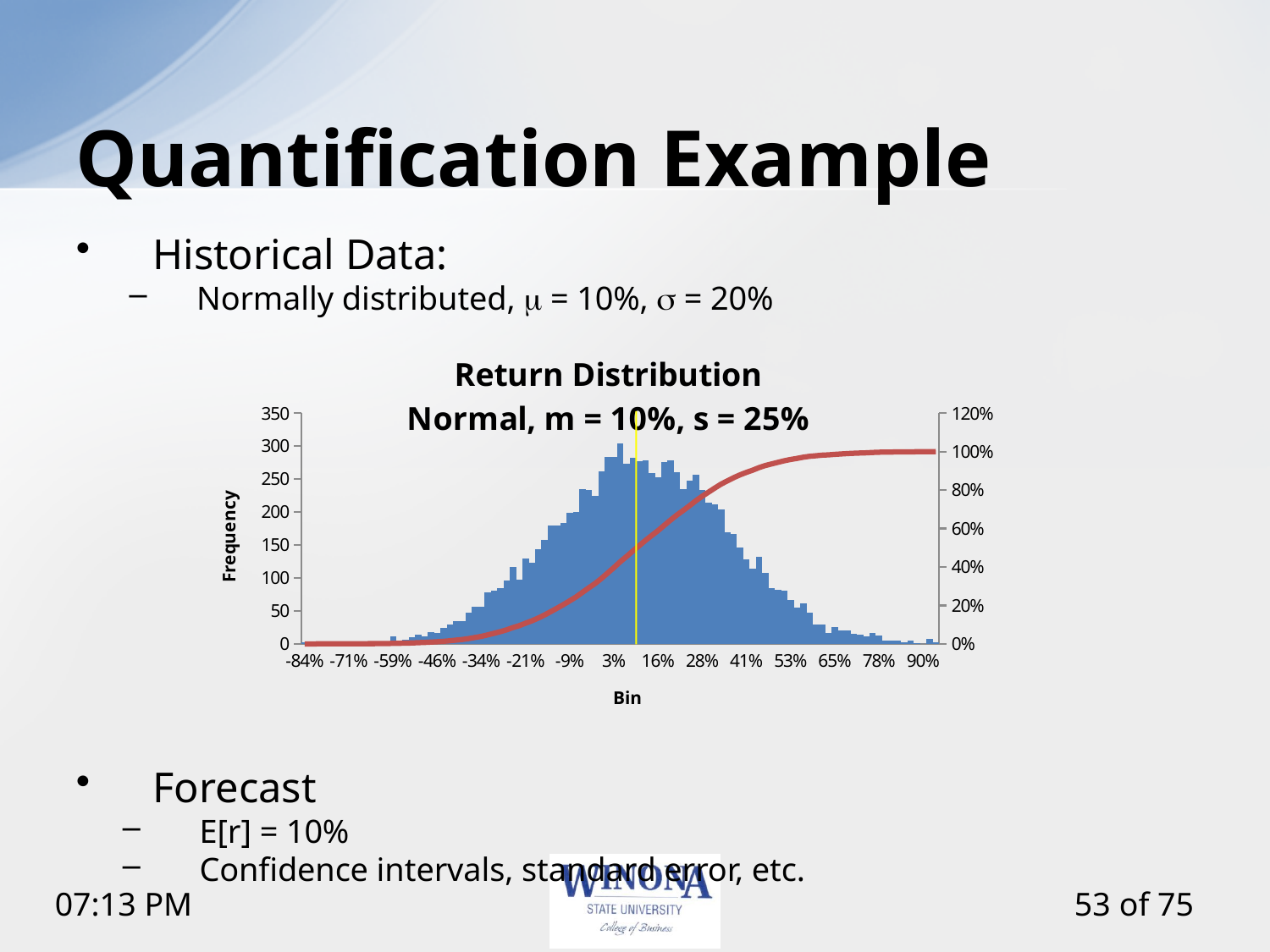
Is the frequency for the 3% bin greater or less than 250? greater What is the title of the chart? Return Distribution Normal, m = 10%, s = 25% What kind of chart is used to show the frequency in the Return Distribution chart? bar chart Which bin has a higher frequency, 3% or 78%? 3% Is the frequency for the -46% bin greater or less than 50? less Is the frequency for the 65% bin greater or less than 50? less What is the label of the x axis of the chart? Bin Does the red cumulative line rise or fall as the bin values increase along the x axis? rise